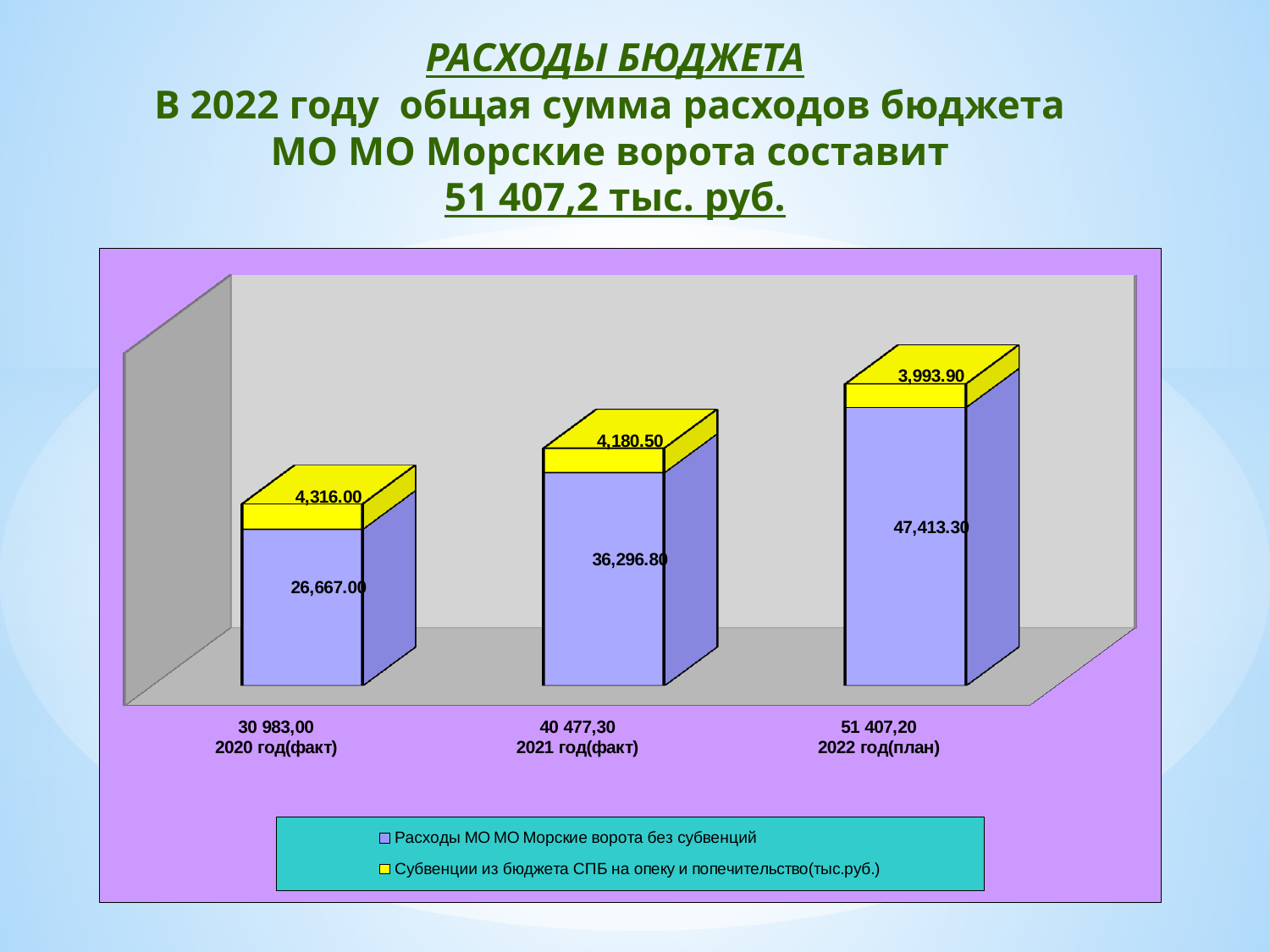
What is the value of 'Расходы МО МО Морские ворота без субвенций' for 2020 год(факт)? 26,667.00 What is the value of 'Субвенции из бюджета СПБ на опеку и попечительство' for 2021 год(факт)? 4,180.50 What type of chart is shown on the slide? bar chart What is the value of 'Субвенции из бюджета СПБ на опеку и попечительство' for 2022 год(план)? 3,993.90 How many series does the legend list? 2 Does the value of 'Расходы МО МО Морские ворота без субвенций' rise or fall from 2020 to 2022? rise Which year has the lowest value for 'Субвенции из бюджета СПБ на опеку и попечительство'? 2022 год(план) Which year has the highest value for 'Расходы МО МО Морские ворота без субвенций'? 2022 год(план) What is the value of 'Расходы МО МО Морские ворота без субвенций' for 2022 год(план)? 47,413.30 What is the total of the stacked bar for 2021 год(факт)? 40 477,30 What is the difference between 'Расходы МО МО Морские ворота без субвенций' in 2021 год(факт) and 2020 год(факт)? 9,629.80 How many categories (years) are plotted on the chart? 3